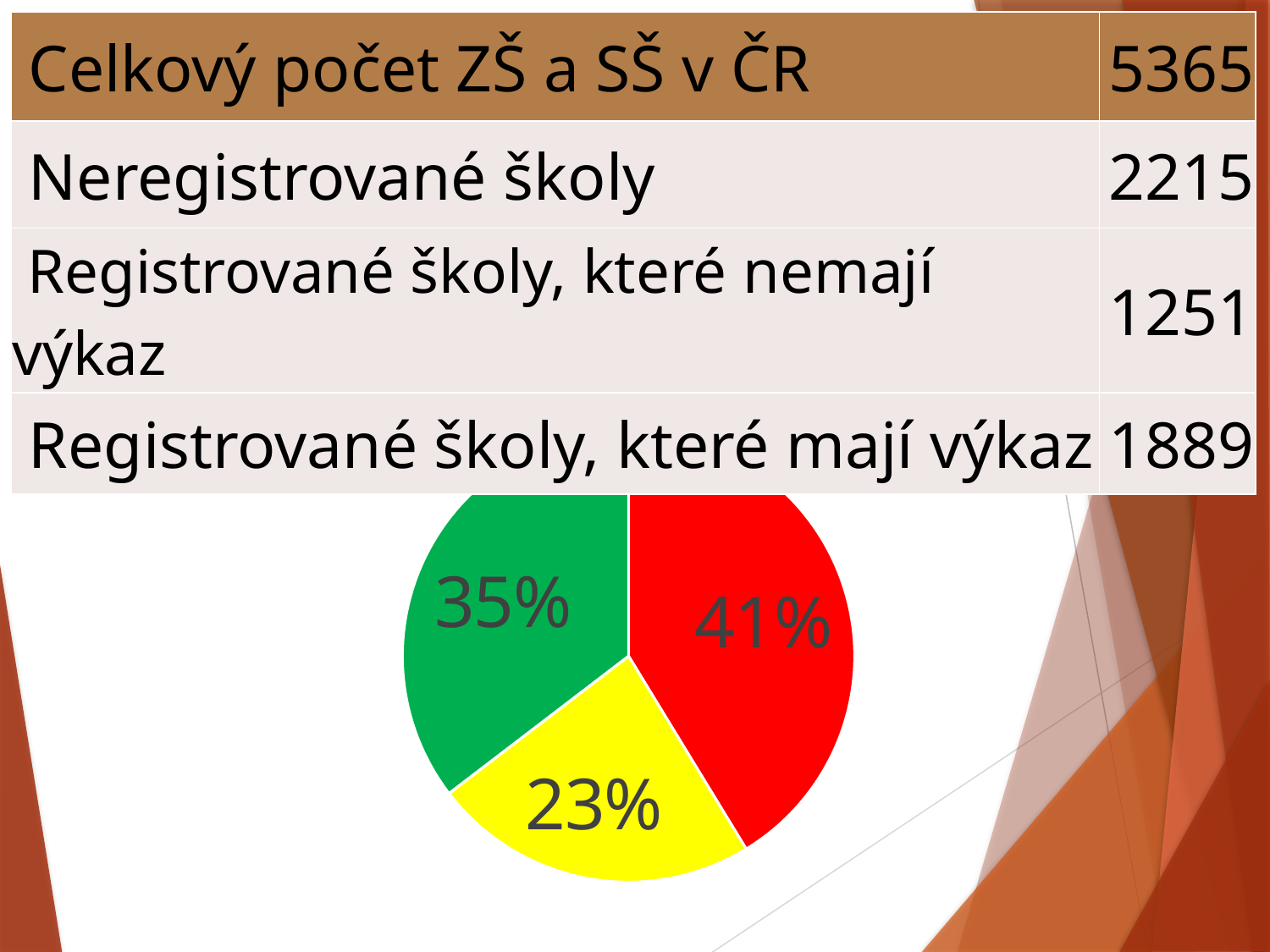
Which slice of the pie chart is the smallest? the yellow slice (23%) Does the pie chart have a legend? no Which slice of the pie chart is the largest? the red slice (41%) Which is larger in the pie chart, the green slice or the yellow slice? the green slice What is the difference in percentage points between the red slice and the green slice? 6 What percentage is shown on the yellow slice of the pie chart? 23% How many slices does the pie chart have? 3 What colours are the three slices of the pie chart? red, yellow and green What is the difference in percentage points between the red slice and the yellow slice? 18 What percentage is shown on the green slice of the pie chart? 35% What percentage is shown on the red slice of the pie chart? 41% What kind of chart is shown on the slide? pie chart